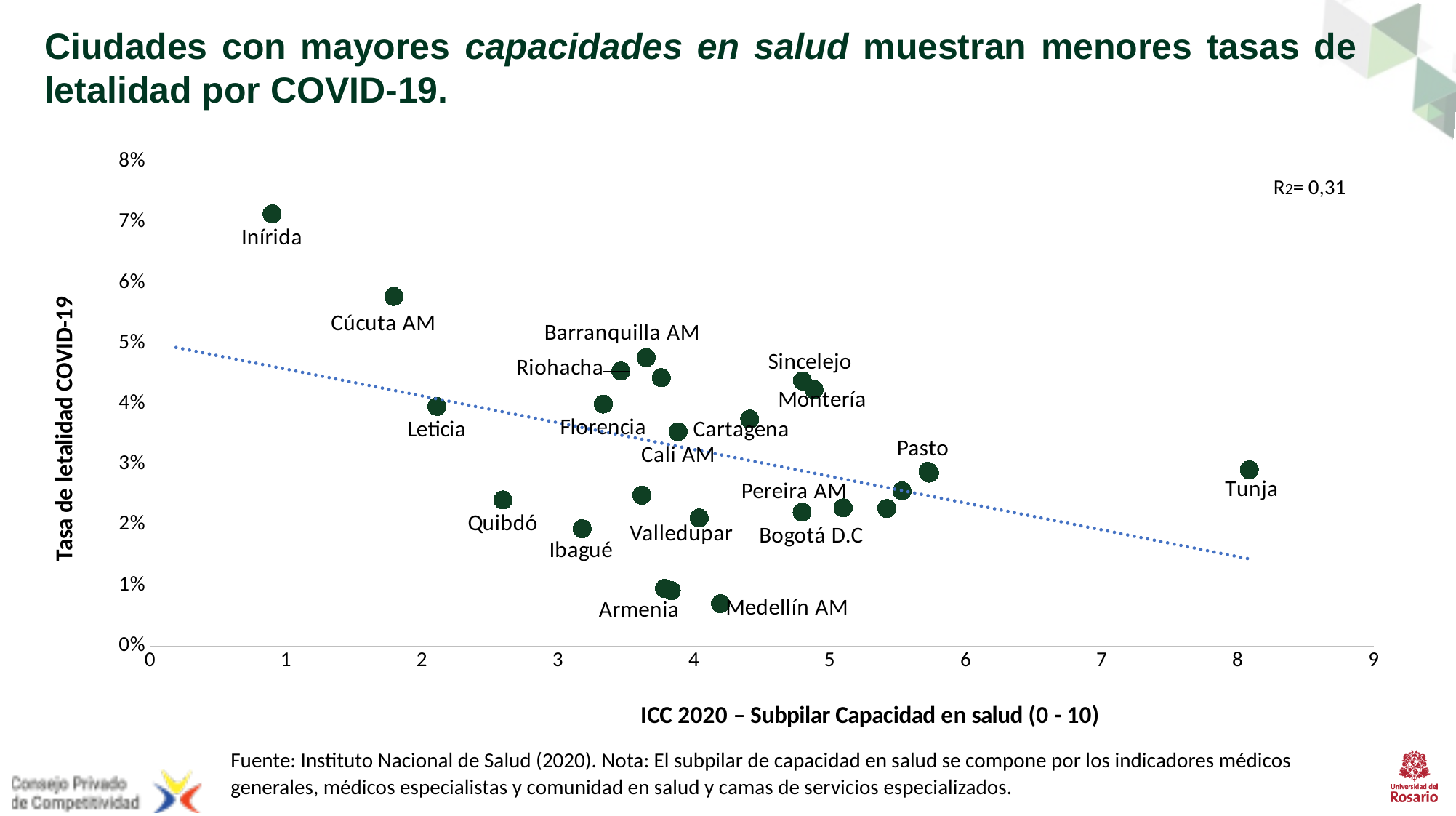
Is the fatality rate for Cúcuta AM greater or less than 5%? greater Which city has the highest COVID-19 fatality rate (Tasa de letalidad COVID-19)? Inírida What kind of chart is shown on the slide? scatter plot Does the dotted trend line show fatality rates rising or falling as the health capacity score increases? falling Is the ICC 2020 health capacity score for Tunja greater or less than 7? greater Which city has the lowest ICC 2020 health capacity score (x axis)? Inírida Is the fatality rate for Medellín AM greater or less than 1%? less Which labelled city has the lowest COVID-19 fatality rate? Medellín AM Which city has a higher fatality rate, Inírida or Cúcuta AM? Inírida Which city has the highest ICC 2020 health capacity score (x axis)? Tunja What R2 value is shown on the chart? 0,31